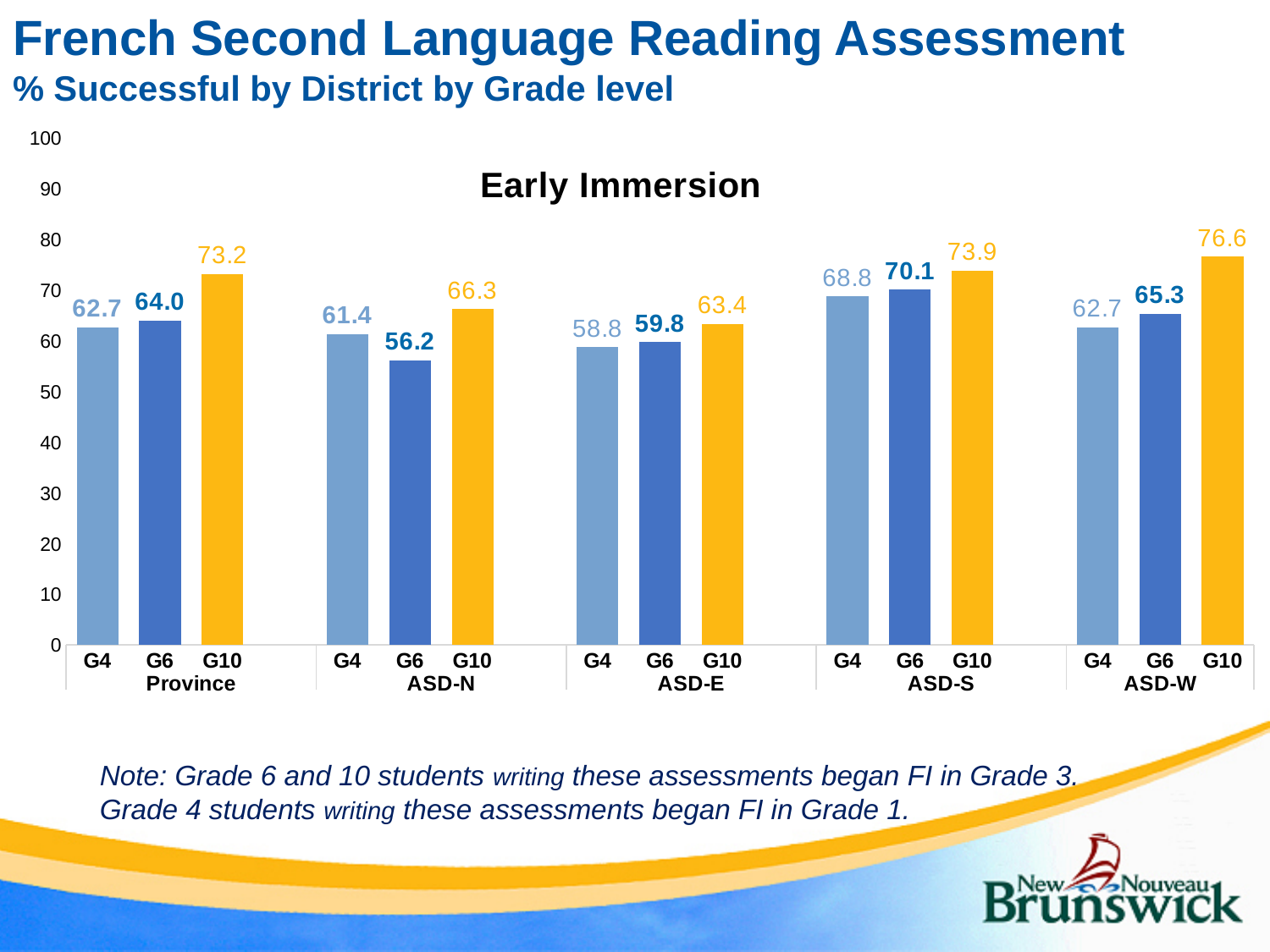
Which is larger in the Early Immersion chart: the G6 value for ASD-S or the G6 value for ASD-E? G6 value for ASD-S What kind of chart is the Early Immersion chart? bar chart What is the G6 value for ASD-N in the Early Immersion chart? 56.2 What is the G4 value for the Province in the Early Immersion chart? 62.7 Do the values for ASD-S rise or fall from G4 to G10 in the Early Immersion chart? rise What is the title shown above the bars in the chart? Early Immersion What is the difference between the G10 and G4 values for ASD-S in the Early Immersion chart? 5.1 What is the G10 value for ASD-W in the Early Immersion chart? 76.6 How many districts are shown on the x axis of the Early Immersion chart? 5 Which district has the highest G10 value in the Early Immersion chart? ASD-W Is the G10 value for ASD-N in the Early Immersion chart greater or less than 70? less Which district has the lowest G4 value in the Early Immersion chart? ASD-E